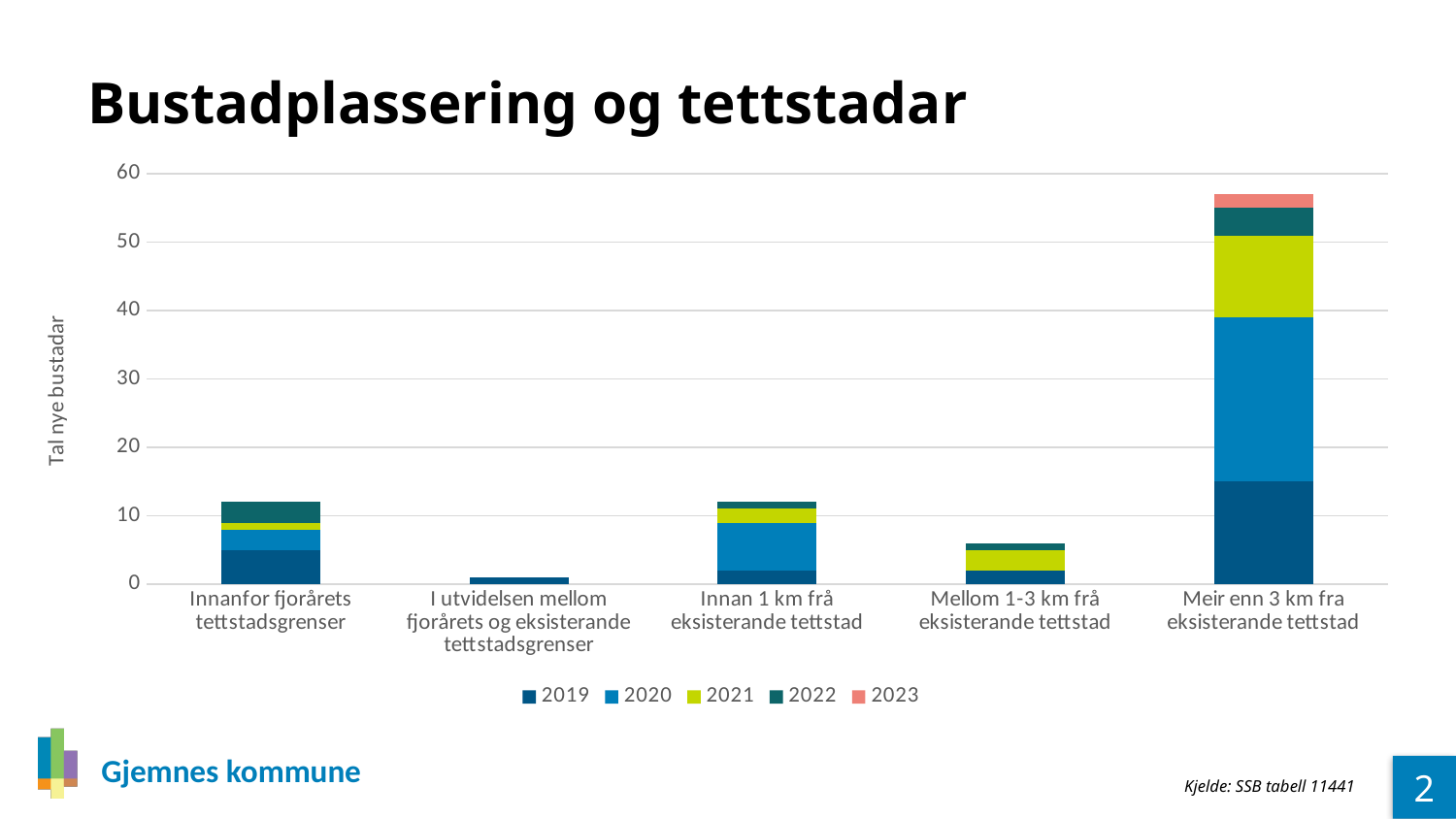
How many series does the legend list? 5 What kind of chart is shown on the slide? Stacked bar chart Which category has the lowest total number of new dwellings? I utvidelsen mellom fjorårets og eksisterande tettstadsgrenser Which has a larger total: 'Innanfor fjorårets tettstadsgrenser' or 'Mellom 1-3 km frå eksisterande tettstad'? Innanfor fjorårets tettstadsgrenser Is the 2020 segment for 'Meir enn 3 km frå eksisterande tettstad' greater or less than 20? greater Is the total for 'Mellom 1-3 km frå eksisterande tettstad' greater or less than 10? less How many categories are shown along the x axis? 5 What is the label on the y axis? Tal nye bustadar Is the total for 'Innanfor fjorårets tettstadsgrenser' greater or less than 10? greater What is the title of the chart? Bustadplassering og tettstadar Which category has the highest total number of new dwellings? Meir enn 3 km fra eksisterande tettstad